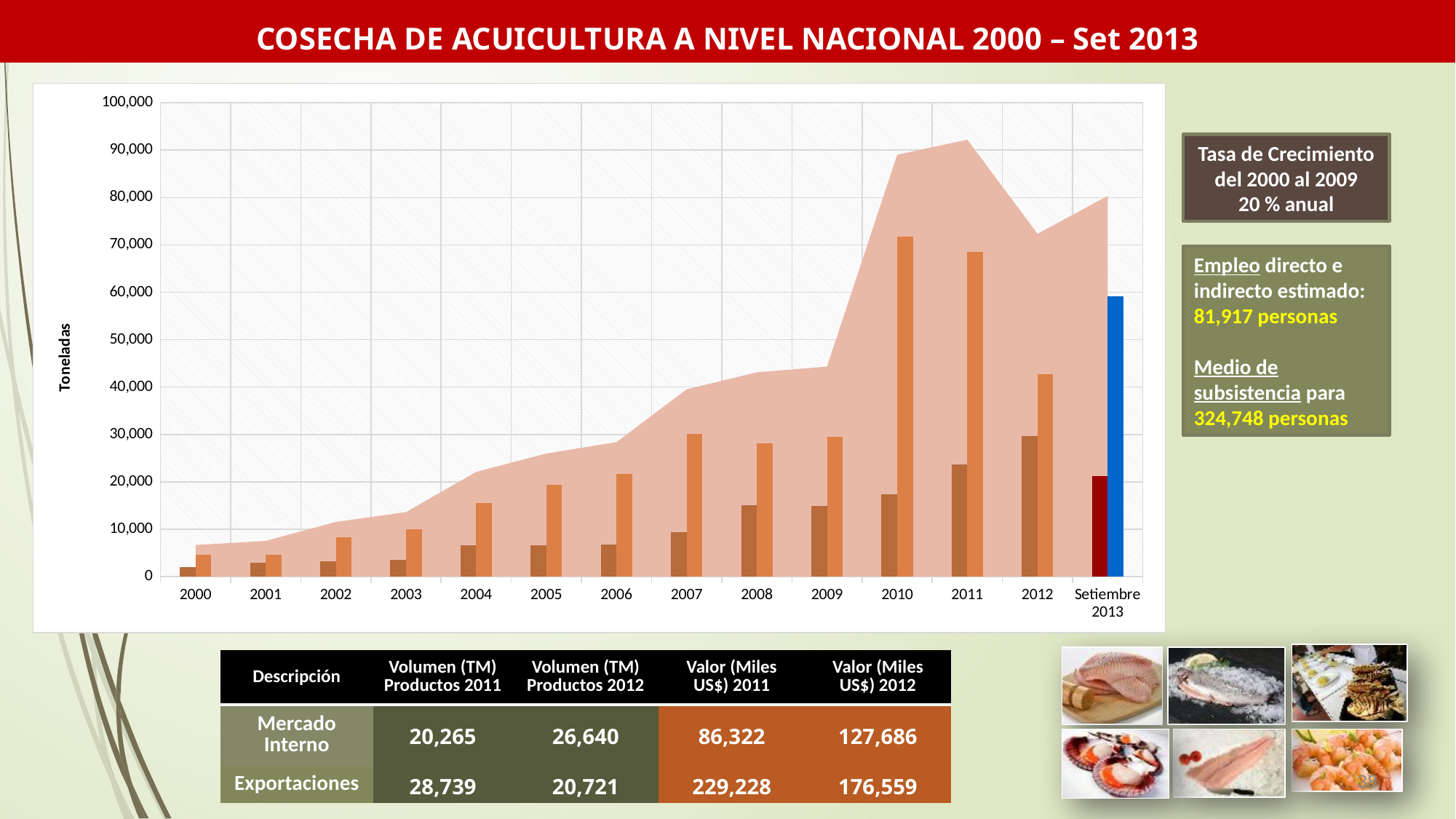
In which year does the shaded area reach its highest value? 2011 How many categories are shown along the x axis of the chart? 14 What is the last category on the x axis of the chart? Setiembre 2013 What is the label on the vertical axis of the chart? Toneladas In which year are the bars and the shaded area at their lowest? 2000 Does the shaded area generally rise or fall from 2000 to 2011? rise In which year does the orange bar reach its highest value? 2010 Which year has the larger orange bar, 2010 or 2011? 2010 Is the orange bar for 2012 greater or less than 40,000? greater Is the blue bar for Setiembre 2013 greater or less than 50,000? greater Is the orange bar for 2011 greater or less than 70,000? less What kind of chart is shown on the slide? bar chart combined with an area chart